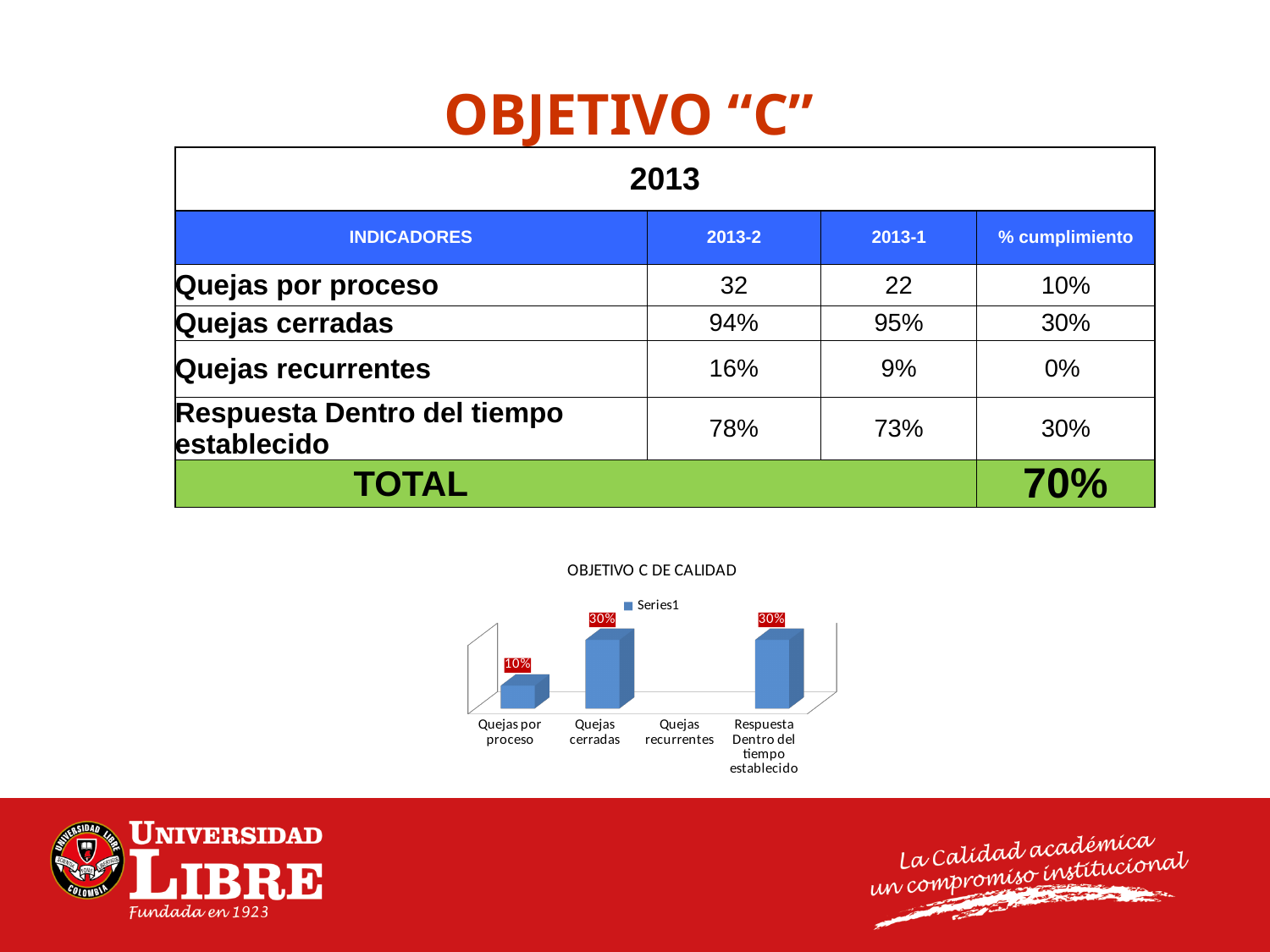
Which category has the lowest value in the chart? Quejas recurrentes Which is larger, the value for Respuesta Dentro del tiempo establecido or the value for Quejas recurrentes? Respuesta Dentro del tiempo establecido What is the value for Quejas cerradas in the chart? 30% What is the value for Quejas por proceso in the chart? 10% What kind of chart is shown on the slide? Bar chart What is the name of the series shown in the chart legend? Series1 How many series does the chart legend list? 1 How many categories are shown on the x axis of the chart? 4 What is the value for Respuesta Dentro del tiempo establecido in the chart? 30% What is the difference between the values for Quejas cerradas and Quejas por proceso? 20% What is the title of the chart? OBJETIVO C DE CALIDAD Which is larger, the value for Quejas cerradas or the value for Quejas por proceso? Quejas cerradas